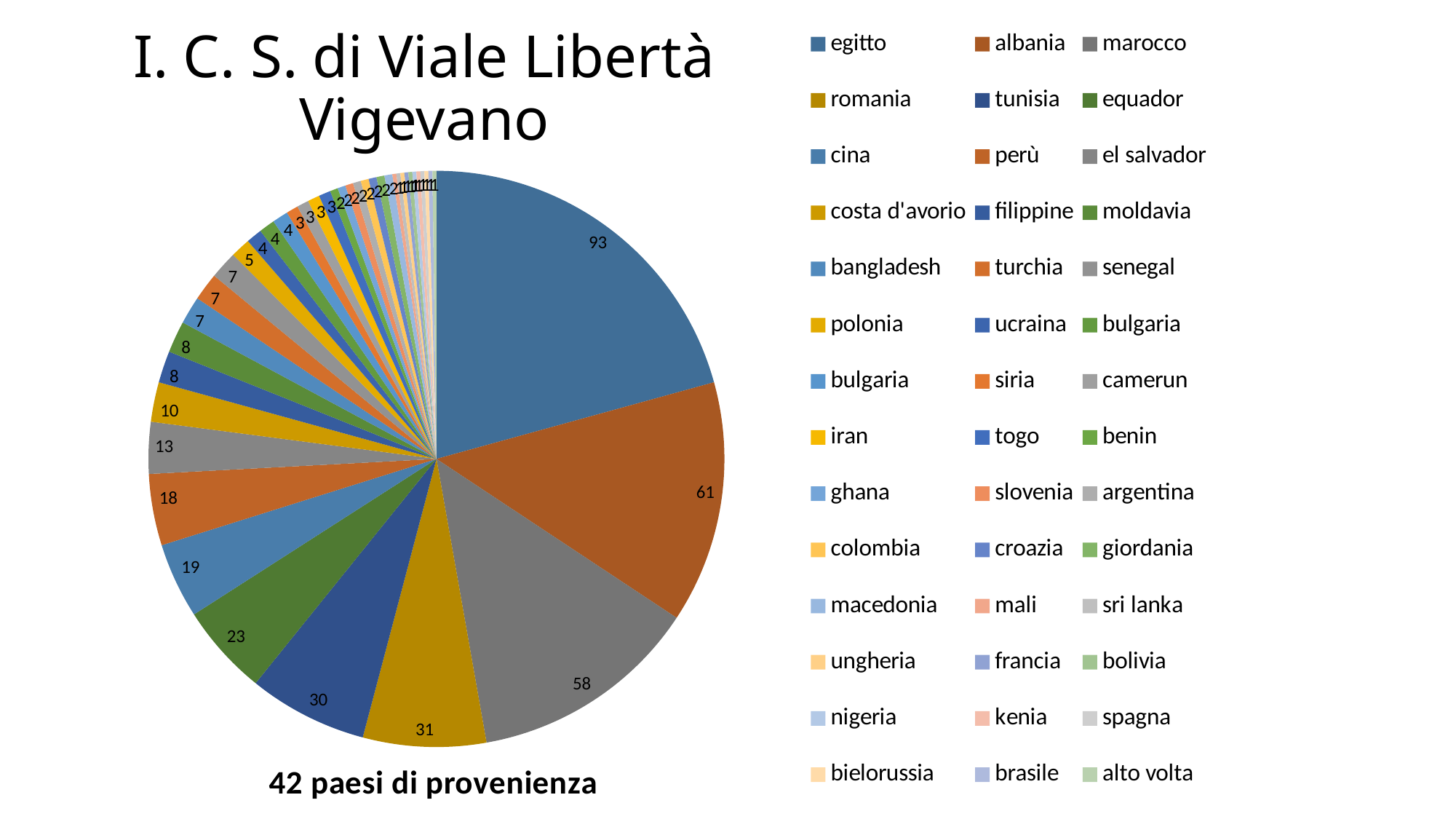
What is the value for egitto? 93 What is the difference between the values for egitto and albania? 32 What is the value for tunisia? 30 What kind of chart is shown on the slide? pie chart What is the value for albania? 61 Which is larger, the value for equador or the value for cina? equador Which country has the largest slice of the pie? egitto What is the value for marocco? 58 What is the value for romania? 31 How many countries of origin does the slide say are represented in the pie chart? 42 What is the title of the slide containing the pie chart? I. C. S. di Viale Libertà Vigevano What is the difference between the values for marocco and romania? 27